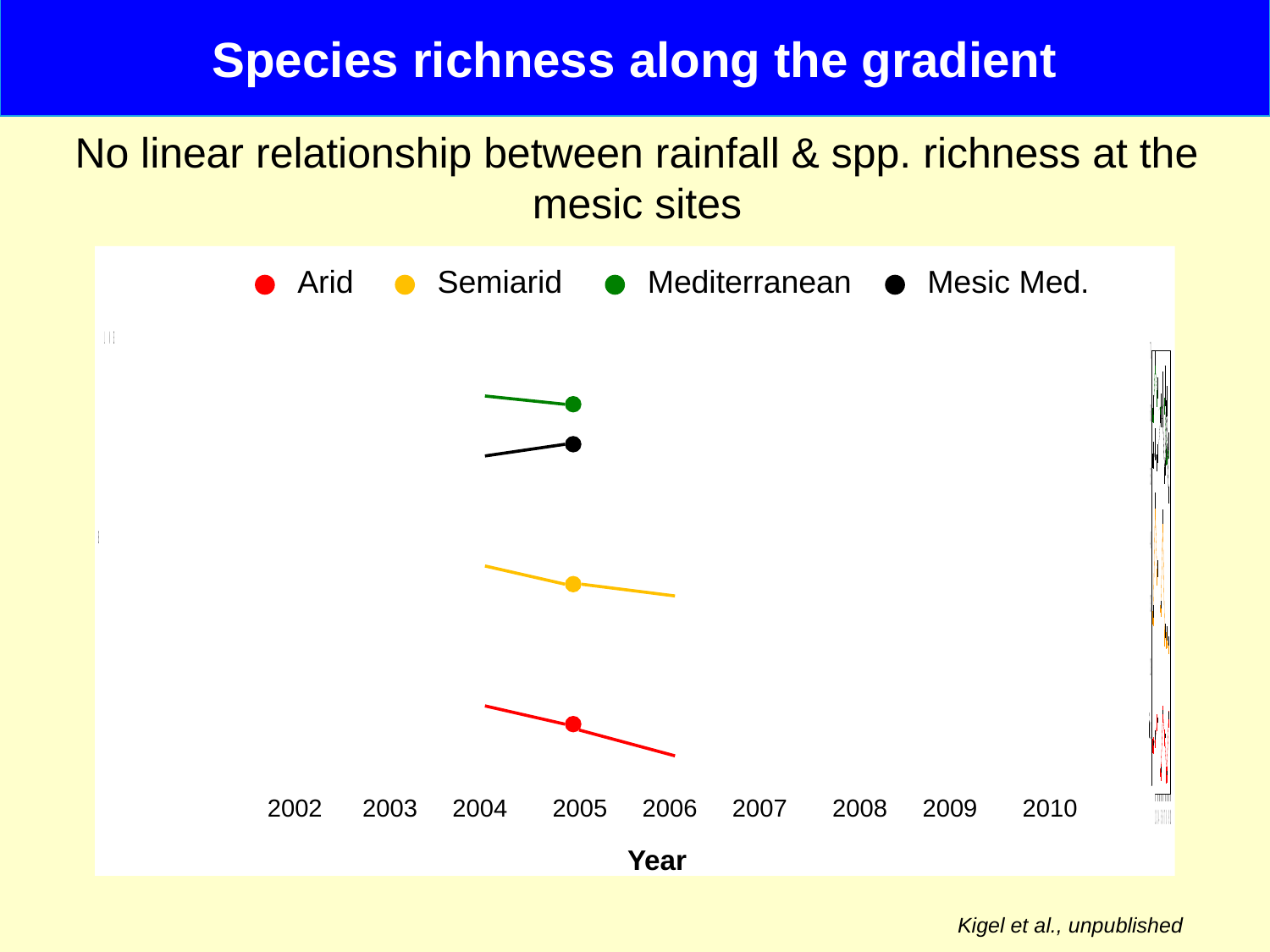
Which series has the highest value at 2005? Mediterranean Does the Arid line rise or fall from 2004 to 2006? fall Does the Semiarid line rise or fall from 2004 to 2006? fall How many series does the legend list? 4 What kind of chart is shown on the slide? line chart How many years are labelled on the x axis? 9 What colour is used for the Arid series? red Which series has the lowest value at 2005? Arid Does the Mesic Med. line rise or fall from 2004 to 2005? rise At 2005, which is larger, the Semiarid value or the Arid value? Semiarid At 2005, which is larger, the Mediterranean value or the Mesic Med. value? Mediterranean What is the label of the x axis? Year